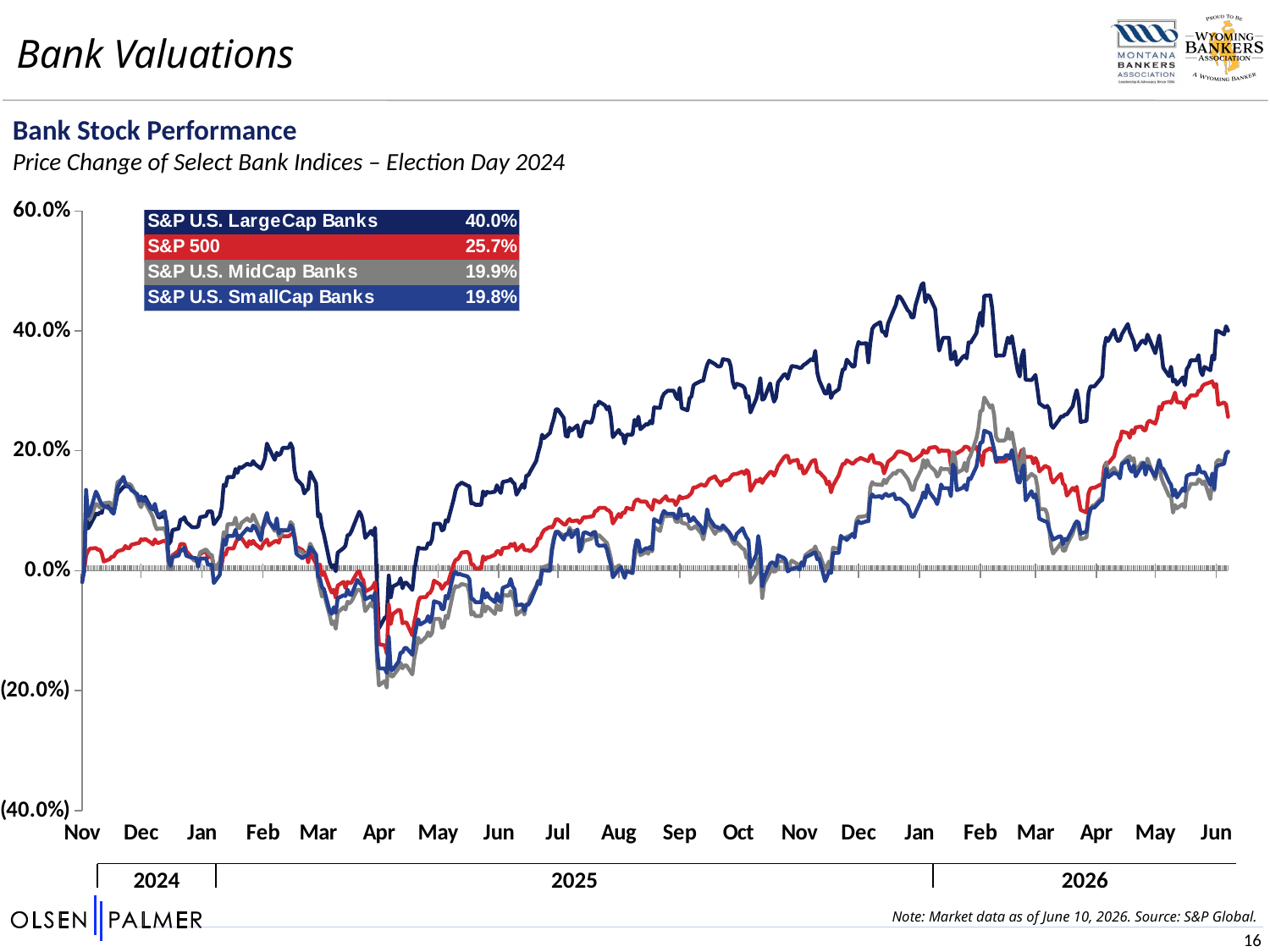
What is the difference between the price change of S&P U.S. LargeCap Banks and the S&P 500 in the legend table? 14.3 percentage points Is the peak value of the S&P U.S. LargeCap Banks line around January 2026 greater or less than 40.0%? greater Does the S&P U.S. LargeCap Banks line generally rise or fall from Nov 2024 to Jun 2026? rise What is the price change shown for S&P U.S. LargeCap Banks in the legend table? 40.0% What is the price change shown for S&P U.S. SmallCap Banks in the legend table? 19.8% What kind of chart is shown on the slide? Line chart What is the price change shown for S&P U.S. MidCap Banks in the legend table? 19.9% How many series does the legend list? 4 Which has a larger price change in the legend table, the S&P 500 or S&P U.S. MidCap Banks? S&P 500 What is the price change shown for the S&P 500 in the legend table? 25.7% Which index has the highest price change in the legend table? S&P U.S. LargeCap Banks What is the subtitle of the chart? Price Change of Select Bank Indices – Election Day 2024